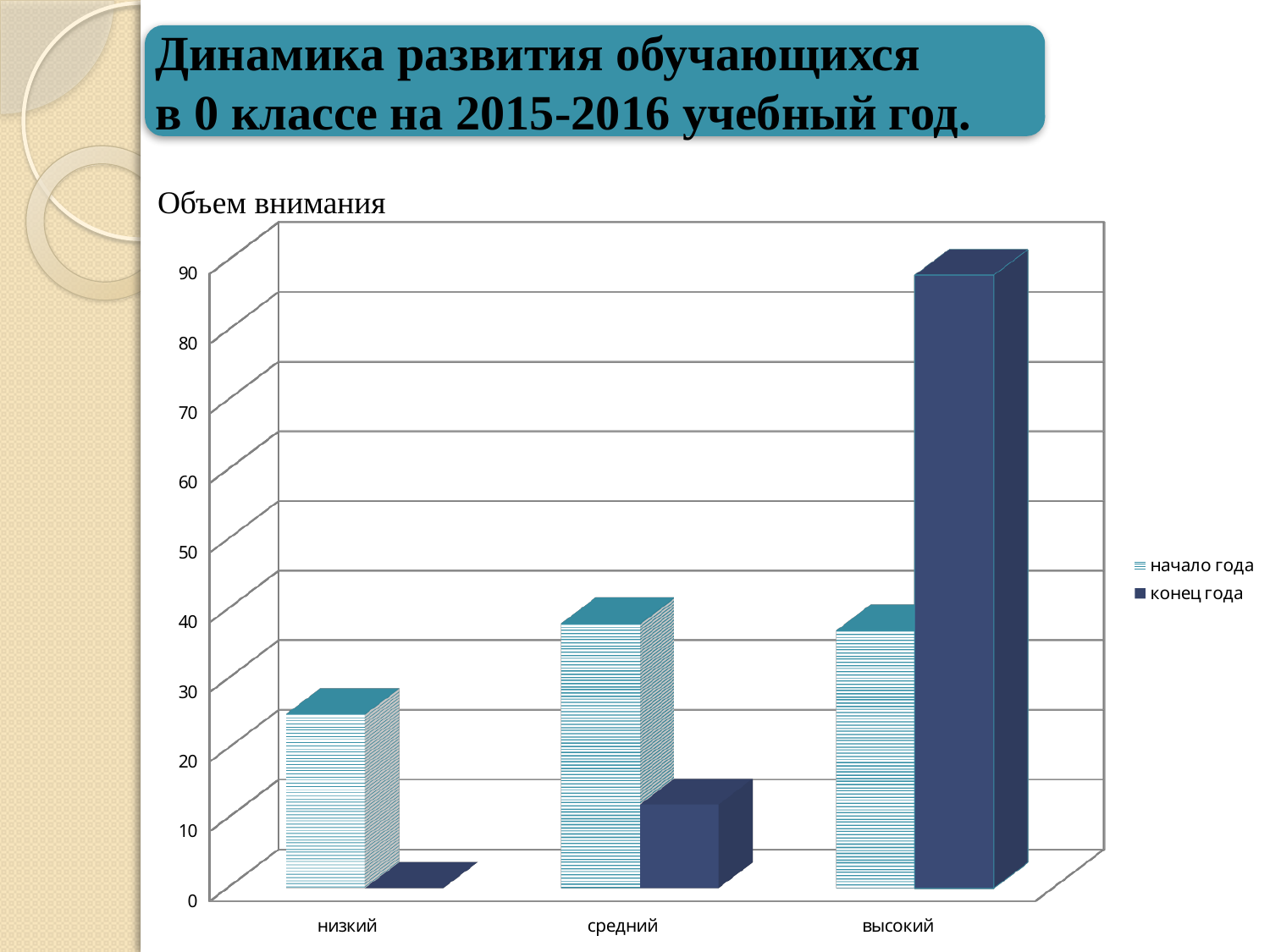
How many categories are shown on the x axis of the chart? 3 What kind of chart is shown on the slide? bar chart Which two series are listed in the chart legend? начало года, конец года For the series конец года, which category has the highest value? высокий What is the title shown above the chart? Объем внимания Is the value for высокий in the series конец года greater or less than 80? greater For the series конец года, which category has the lowest value? низкий Is the value for низкий in the series начало года greater or less than 20? greater For the series начало года, which category has the lowest value? низкий For the category высокий, which series has the larger value, начало года or конец года? конец года Is the value for средний in the series конец года greater or less than 20? less How many series does the chart legend list? 2